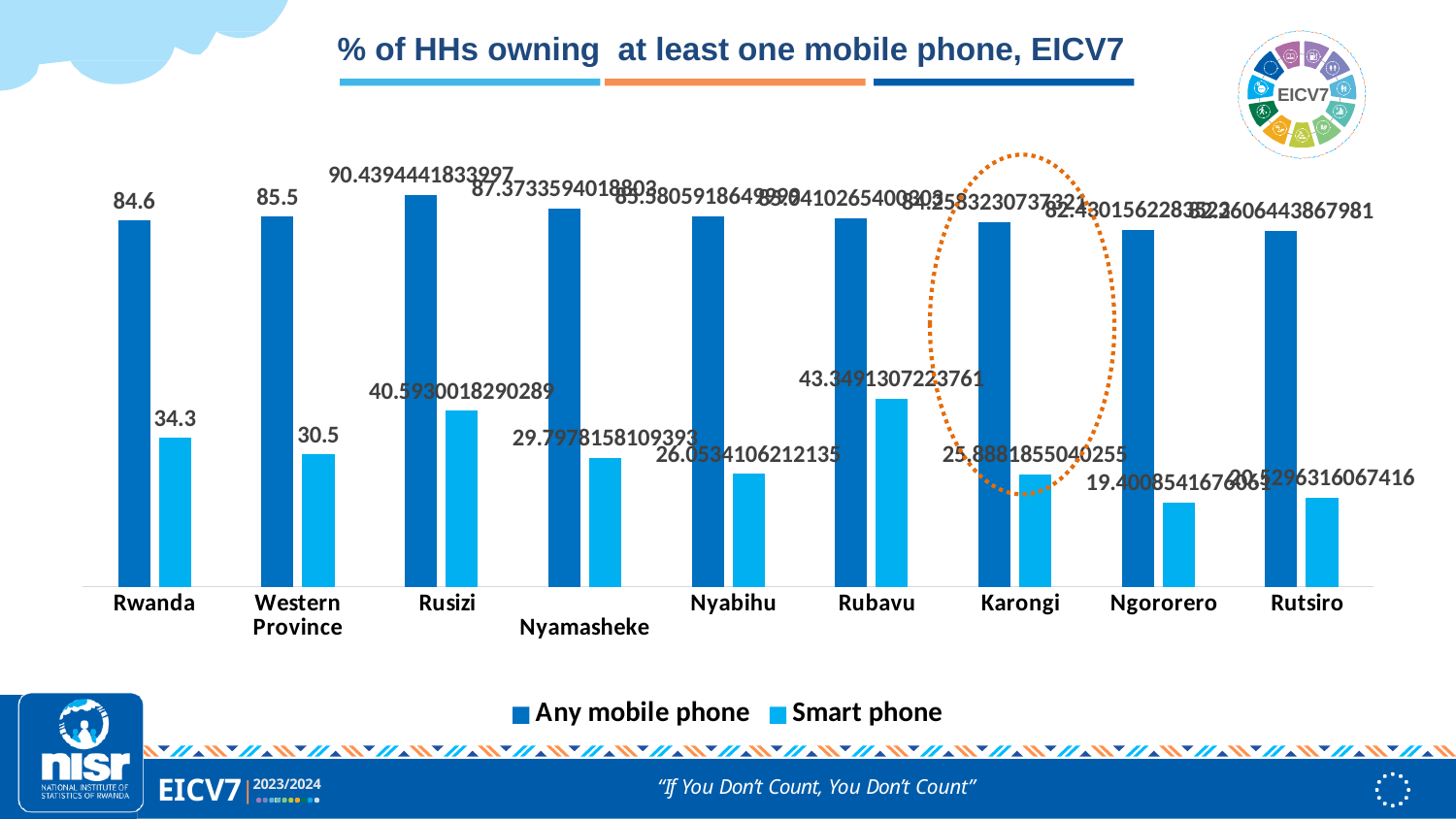
What is the value for Smart phone for Karongi? 25.8881855040255 What is the value for Smart phone for Rubavu? 43.3491307223761 What is the value for Any mobile phone for Rwanda? 84.6 What is the difference between the Any mobile phone and Smart phone values for Rwanda? 50.3 What is the title of the chart? % of HHs owning at least one mobile phone, EICV7 What is the value for Smart phone for Western Province? 30.5 Which category has the highest value for Any mobile phone? Rusizi What kind of chart is shown on the slide? Bar chart How many series does the legend list? 2 How many categories are shown on the x axis? 9 Which category has the highest value for Smart phone? Rubavu Which has a higher Any mobile phone value, Rwanda or Western Province? Western Province